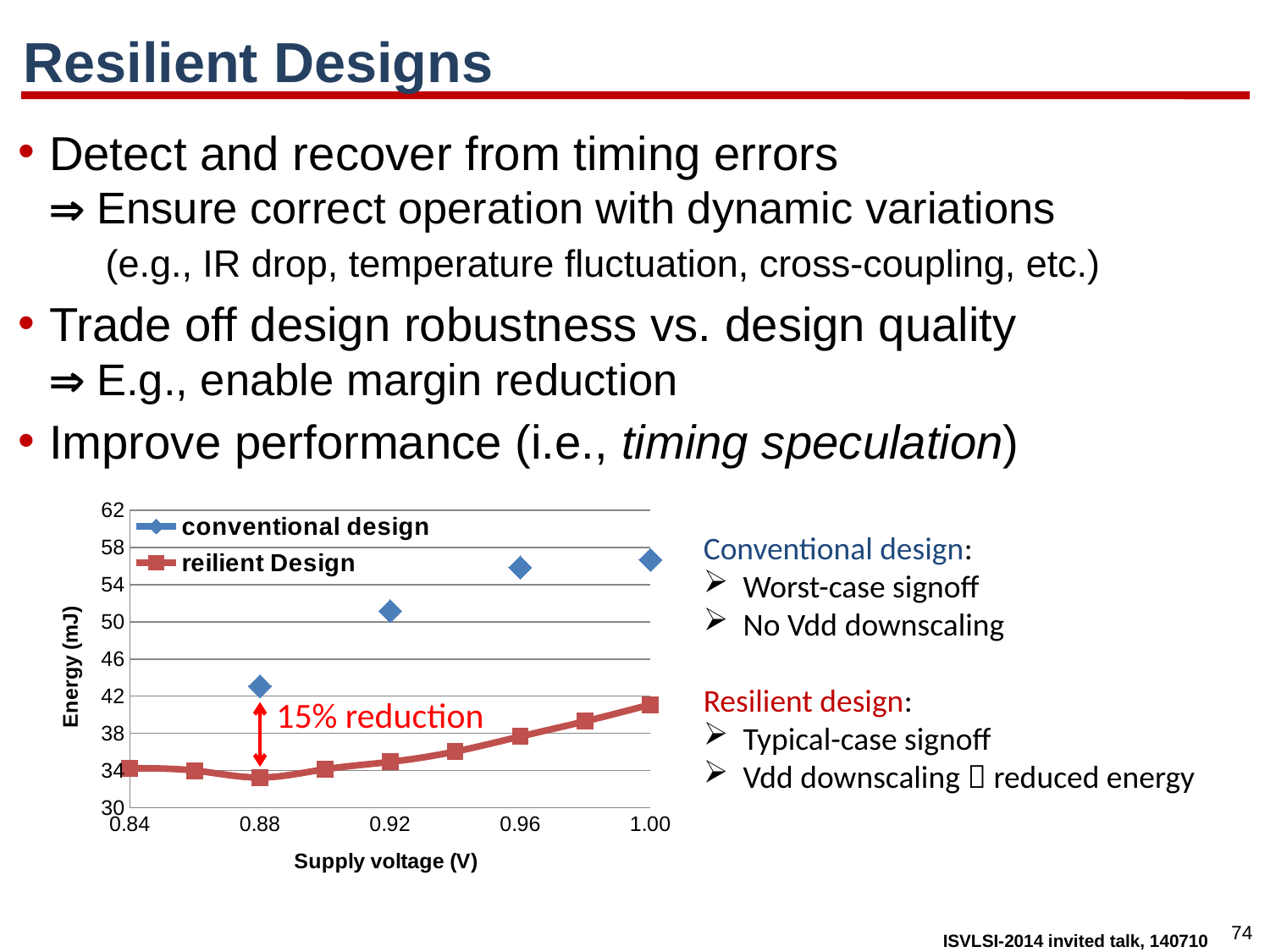
Is the value for reilient Design at a supply voltage of 0.88 greater or less than 38? less What is the title of the vertical axis of the chart? Energy (mJ) Is the value for conventional design at a supply voltage of 0.96 greater or less than 54? greater What reduction is annotated on the chart between the two series at 0.88 V? 15% reduction What kind of chart is shown on the slide? line chart Does the reilient Design series rise or fall as supply voltage increases from 0.88 to 1.00? rise How many series does the chart legend list? 2 At a supply voltage of 0.88, which series has the higher energy value? conventional design How many data points are plotted for the reilient Design series? 9 Is the value for conventional design at a supply voltage of 0.92 greater or less than 46? greater How many data points are plotted for the conventional design series? 4